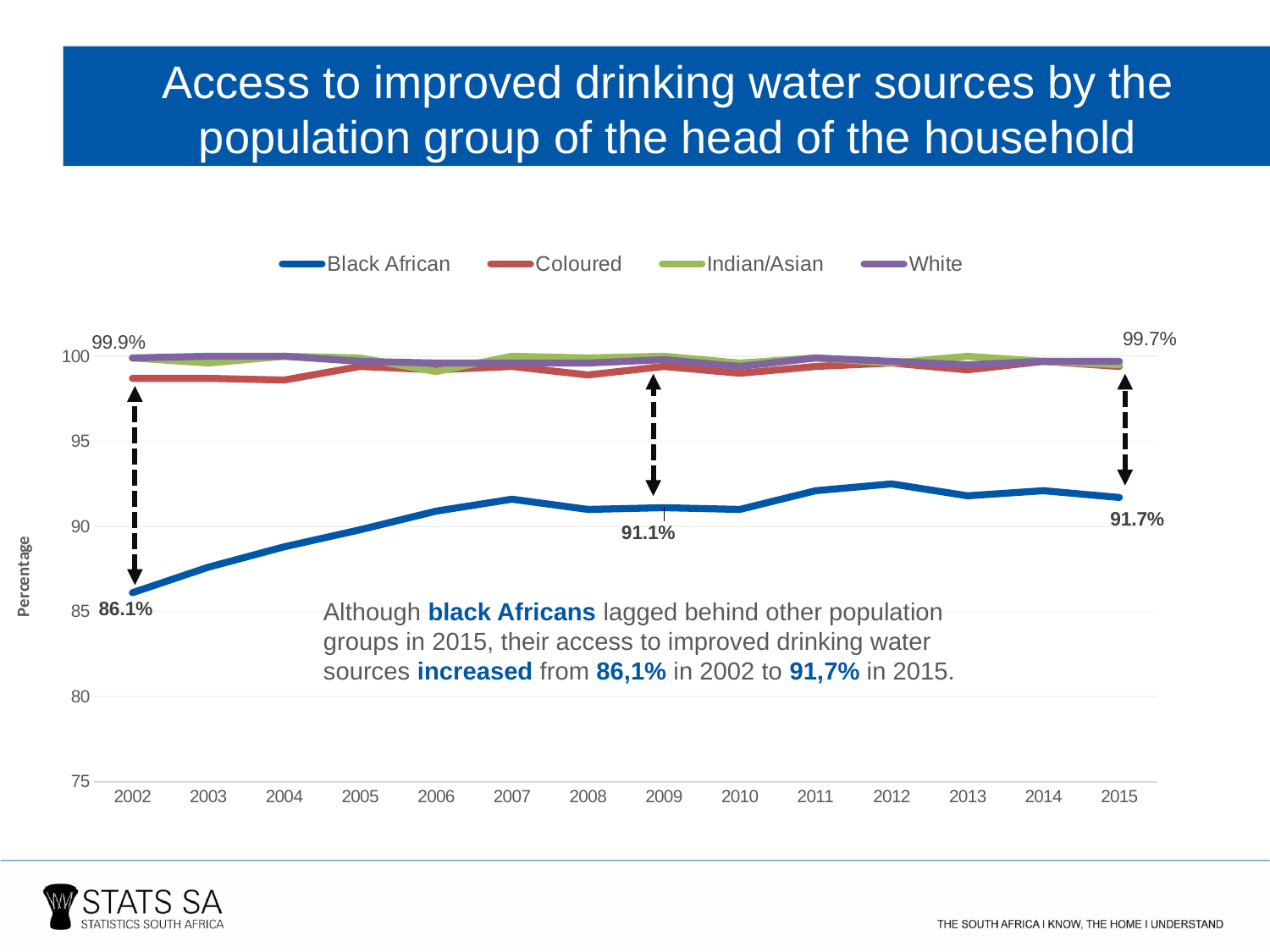
What type of chart is shown on the slide? Line chart How many series does the legend list? 4 By how much did the Black African value change from 2002 to 2015? 5.6 percentage points Is the value for Black African in 2012 greater or less than 90? greater What was the value for Black African in 2009? 91.1% How many years are shown along the x axis? 14 Does the Black African line generally rise or fall from 2002 to 2015? Rise What colour is the line for Black African? Blue Is the value for Black African in 2003 greater or less than 90? less What was the value for Black African in 2002? 86.1% Which population group had the lowest value in 2015? Black African What was the value for Black African in 2015? 91.7%